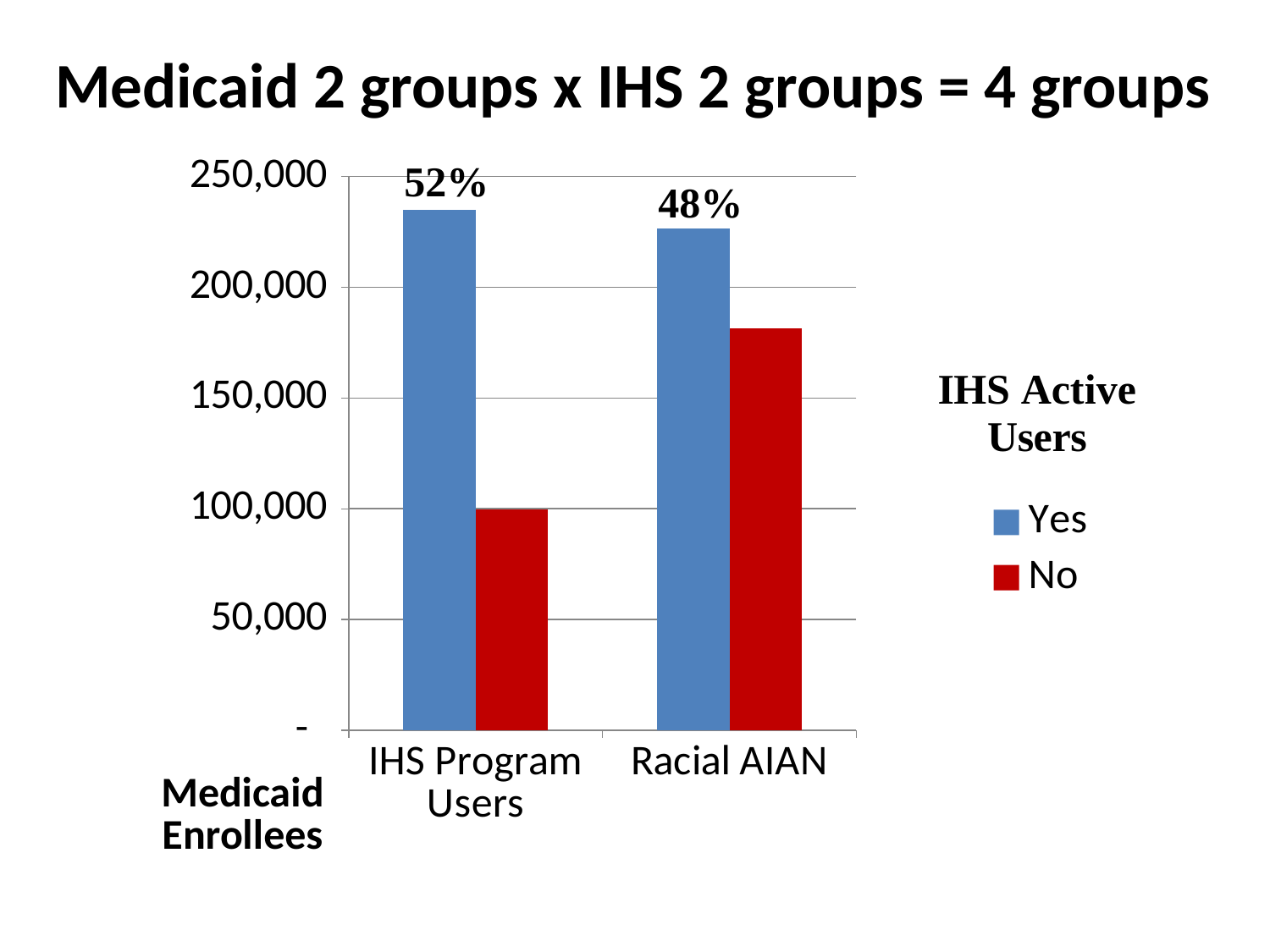
What percentage label is printed above the Yes bar for Racial AIAN? 48% What percentage label is printed above the Yes bar for IHS Program Users? 52% Is the value of the Yes bar for IHS Program Users greater or less than 200,000? greater Which bar in the chart is the lowest? No for IHS Program Users What is the title of the chart's legend? IHS Active Users What label appears below the vertical axis of the chart? Medicaid Enrollees For IHS Program Users, which bar is larger, Yes or No? Yes How many series does the chart's legend list? 2 Is the value of the No bar for IHS Program Users greater or less than 150,000? less How many categories are shown on the x axis of the chart? 2 What kind of chart is shown on the slide? bar chart Is the value of the No bar for Racial AIAN greater or less than 150,000? greater